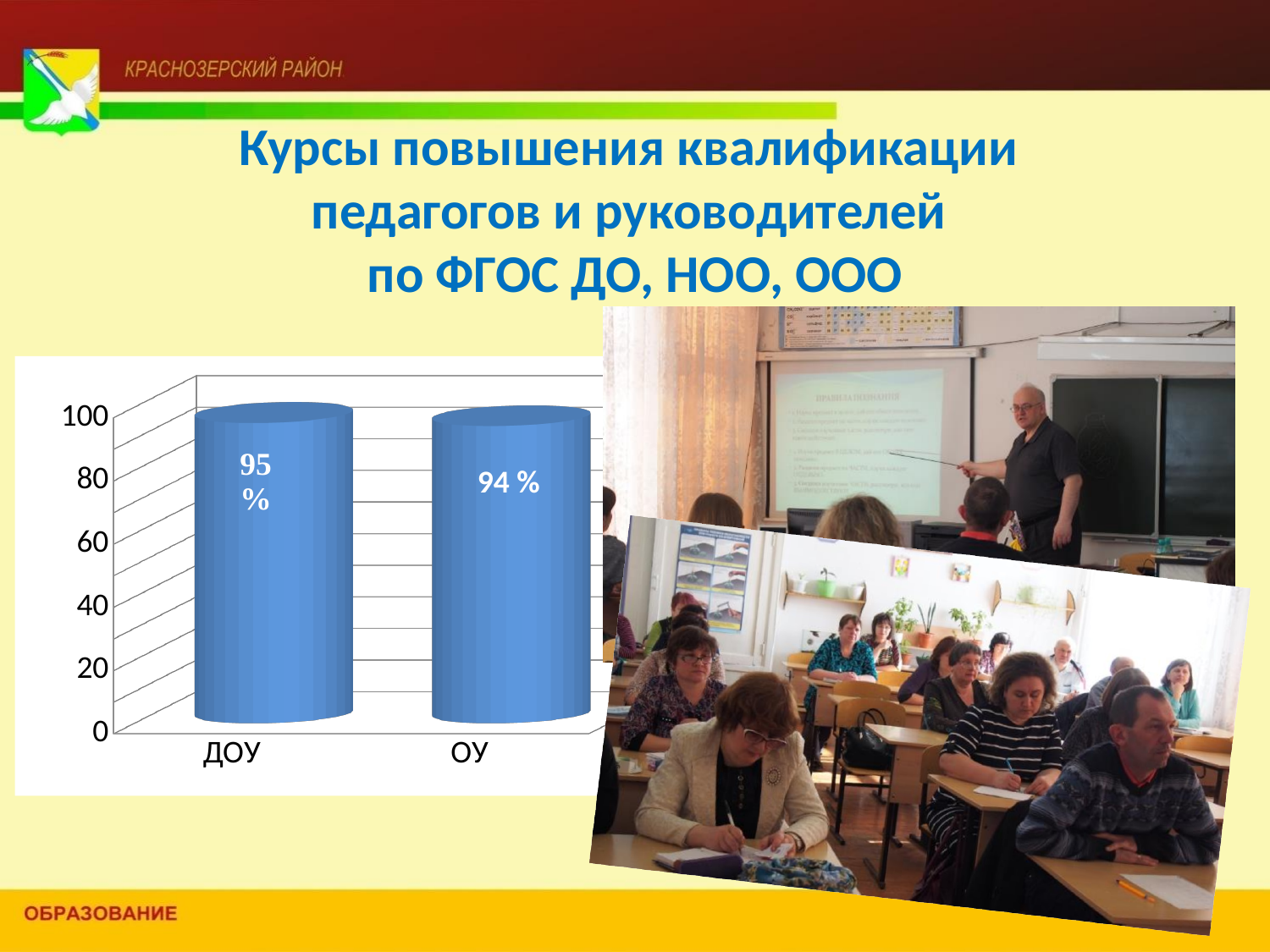
Is the value for ОУ greater or less than 80? greater Which category has the highest value? ДОУ Which category has the higher value, ДОУ or ОУ? ДОУ What is the value shown for ОУ? 94 % How many categories are shown on the chart? 2 What colour are the bars in the chart? blue What is the highest tick value shown on the vertical axis? 100 Which category has the lowest value? ОУ What is the value shown for ДОУ? 95 % What kind of chart is shown on the slide? bar chart Is the value for ДОУ greater or less than 60? greater What is the difference between the values for ДОУ and ОУ? 1 %